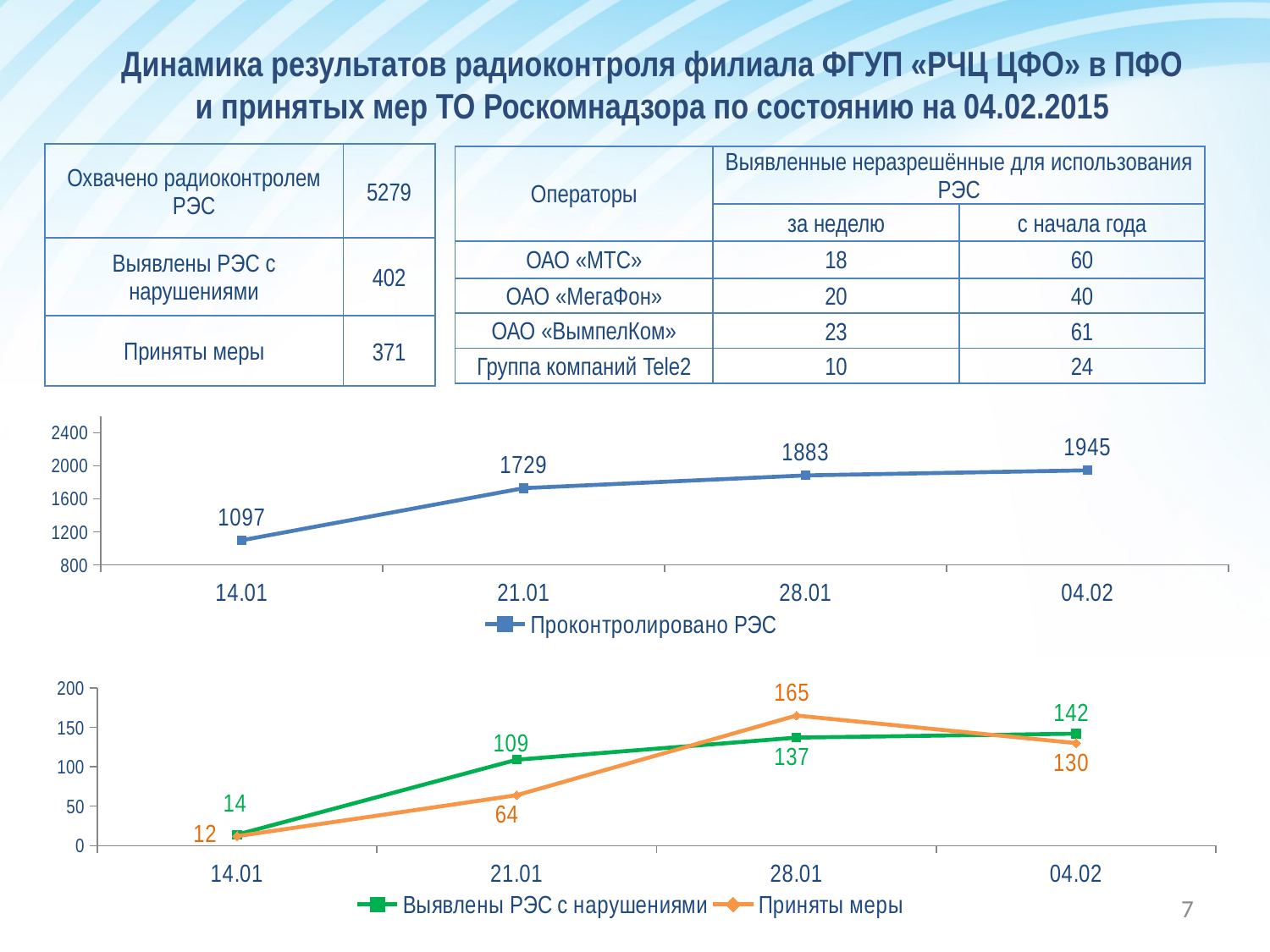
In the bottom chart, how many series does the legend list? 2 In the top chart, how many data points are plotted? 4 In the top chart, on which date is Проконтролировано РЭС lowest? 14.01 In the bottom chart, what is the value of Приняты меры on 28.01? 165 In the bottom chart, what is the difference between Приняты меры and Выявлены РЭС с нарушениями on 28.01? 28 In the top chart, do the values rise or fall from 14.01 to 04.02? rise In the bottom chart, which is larger on 21.01: Выявлены РЭС с нарушениями or Приняты меры? Выявлены РЭС с нарушениями In the top chart, on which date is Проконтролировано РЭС highest? 04.02 In the top chart, what is the difference between the values on 04.02 and 14.01? 848 What type of chart is the bottom chart? line chart In the bottom chart, what is the value of Выявлены РЭС с нарушениями on 21.01? 109 In the top chart, what is the value of Проконтролировано РЭС on 21.01? 1729